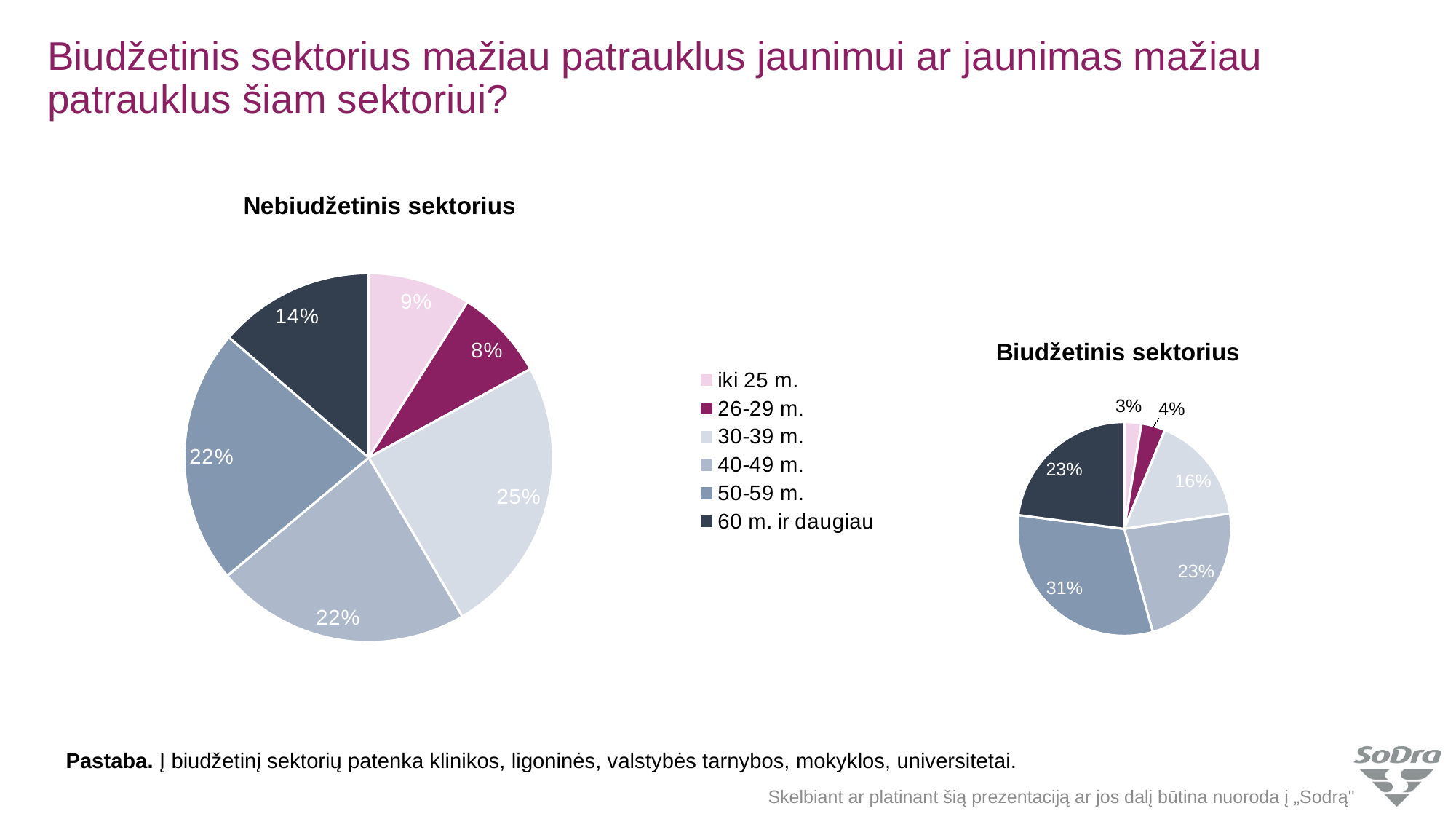
In the "Biudžetinis sektorius" chart, which age group has the smallest share? iki 25 m. In the "Nebiudžetinis sektorius" chart, which age group has the largest share? 30-39 m. In the "Biudžetinis sektorius" chart, what is the share for "50-59 m."? 31% In the "Nebiudžetinis sektorius" chart, which age group has the smallest share? 26-29 m. How many age groups does the legend list? 6 Which is larger: the "60 m. ir daugiau" share in the "Nebiudžetinis sektorius" chart or in the "Biudžetinis sektorius" chart? Biudžetinis sektorius In the "Nebiudžetinis sektorius" chart, what is the share for "iki 25 m."? 9% In the "Biudžetinis sektorius" chart, what is the share for "30-39 m."? 16% In the "Nebiudžetinis sektorius" chart, what is the combined share of "iki 25 m." and "26-29 m."? 17% What type of chart is used for "Nebiudžetinis sektorius"? pie chart In the "Biudžetinis sektorius" chart, which age group has the largest share? 50-59 m. What is the difference between the "iki 25 m." share in the "Nebiudžetinis sektorius" chart and in the "Biudžetinis sektorius" chart? 6 percentage points